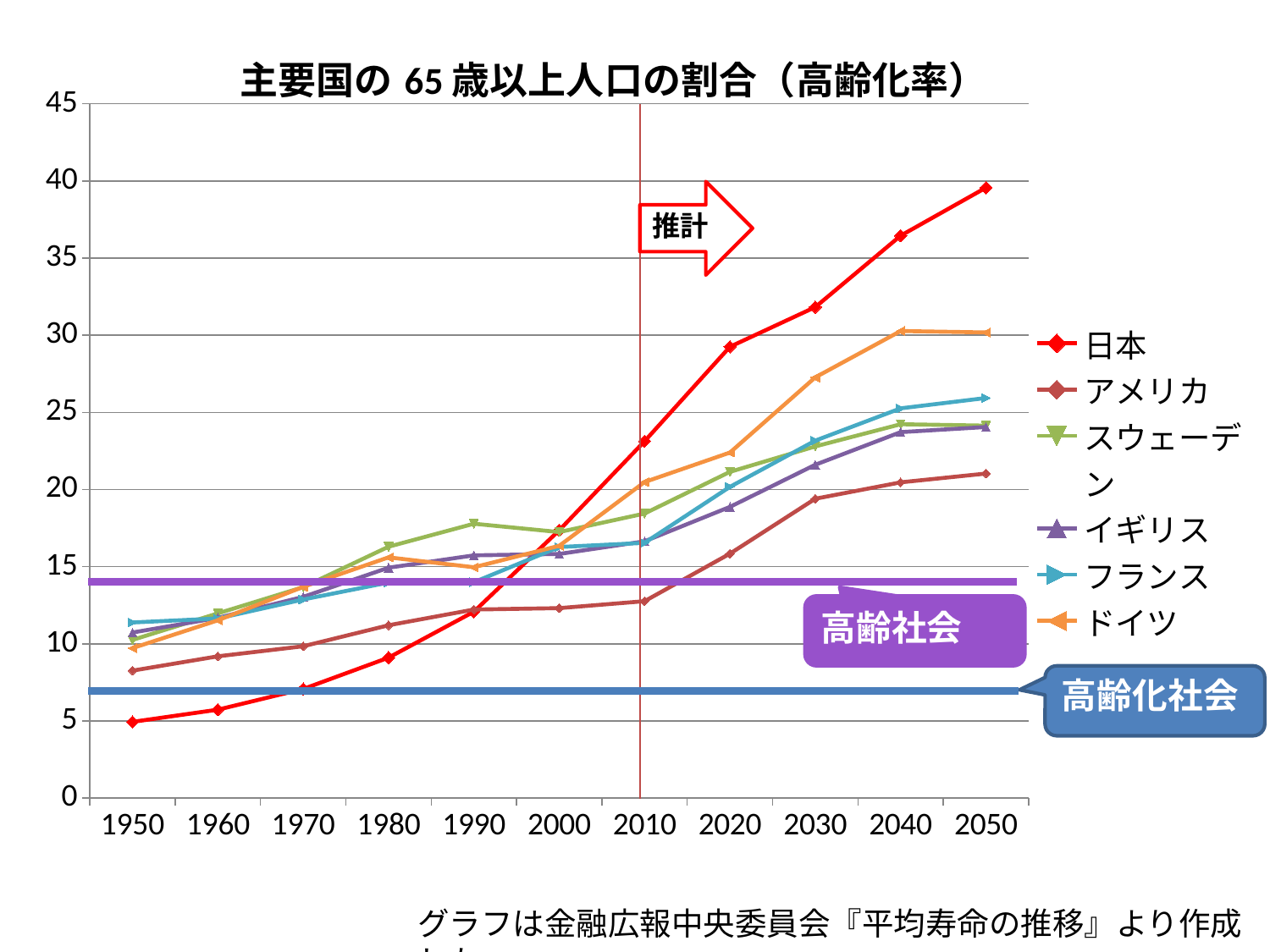
Is the value for 日本 in 2050 greater or less than 35? greater Is the value for 日本 in 1950 greater or less than 10? less What kind of chart is shown on the slide? line chart Which country has the lowest value in 2050? アメリカ Do the values for 日本 rise or fall from 1950 to 2050? rise Is the value for ドイツ in 2040 greater or less than 25? greater In 2040, which is larger, the value for ドイツ or the value for フランス? ドイツ How many years are marked along the x axis? 11 What is the title of the chart? 主要国の65歳以上人口の割合（高齢化率） How many series does the legend list? 6 Which country has the highest value in 2050? 日本 Which country has the lowest value in 1950? 日本